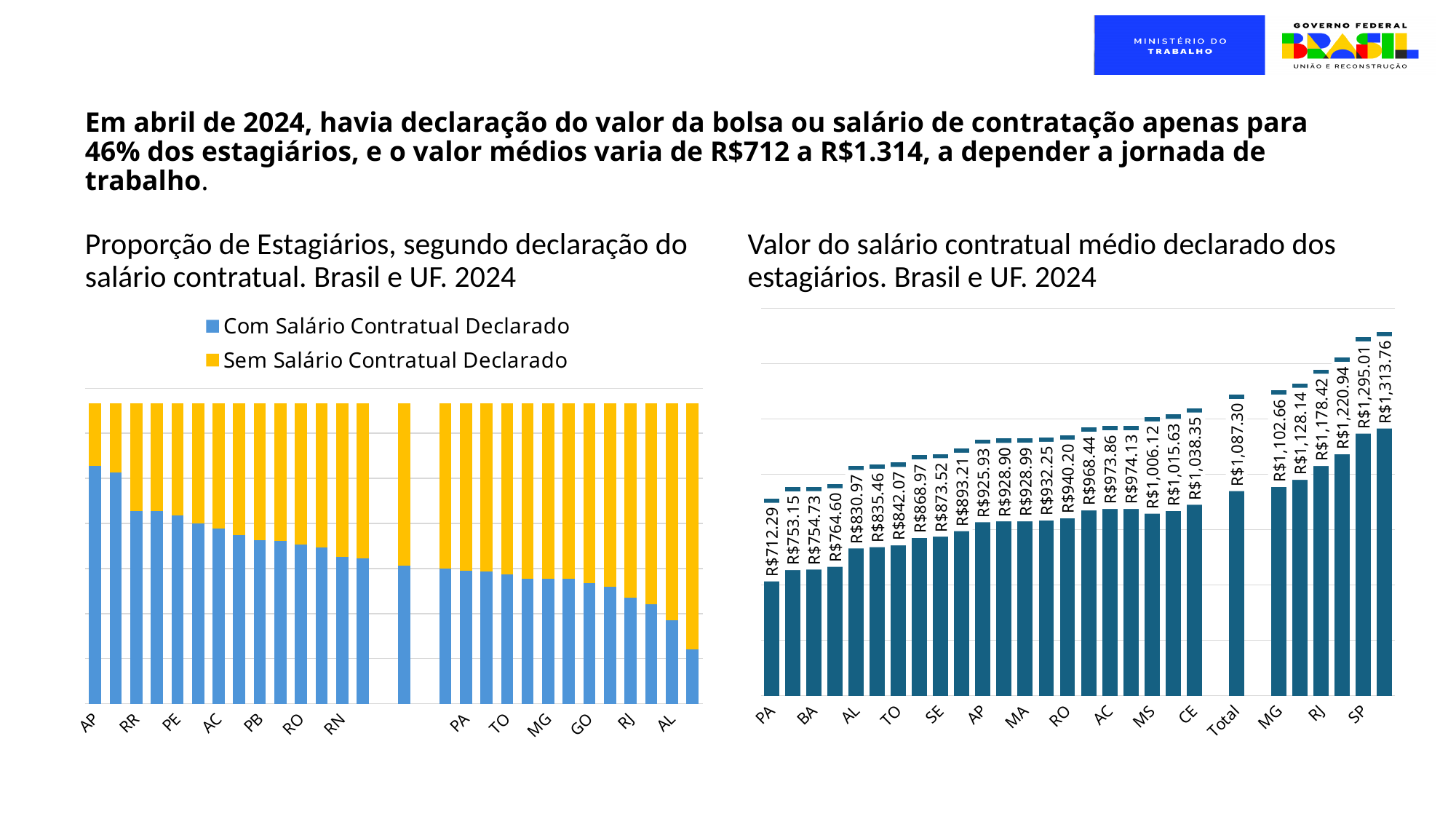
In the right chart, which labelled category has the lowest value? PA In the right chart, what is the value for Total? R$1,087.30 What kind of chart is the left chart, 'Proporção de Estagiários, segundo declaração do salário contratual'? Stacked bar chart In the right chart, 'Valor do salário contratual médio declarado dos estagiários', what is the value for PA? R$712.29 In the right chart, which is larger, the value for MS or the value for CE? CE In the left chart, is the 'Com Salário Contratual Declarado' portion larger for AP or for AL? AP In the right chart, what is the difference between the Total value and the PA value? R$375.01 In the right chart, what is the value for CE? R$1,038.35 How many series does the legend of the left chart list? 2 In the right chart, how many bars are plotted? 28 In the left chart, does the 'Com Salário Contratual Declarado' portion rise or fall from left to right across the bars? Fall In the left chart, which series is shown in yellow? Sem Salário Contratual Declarado